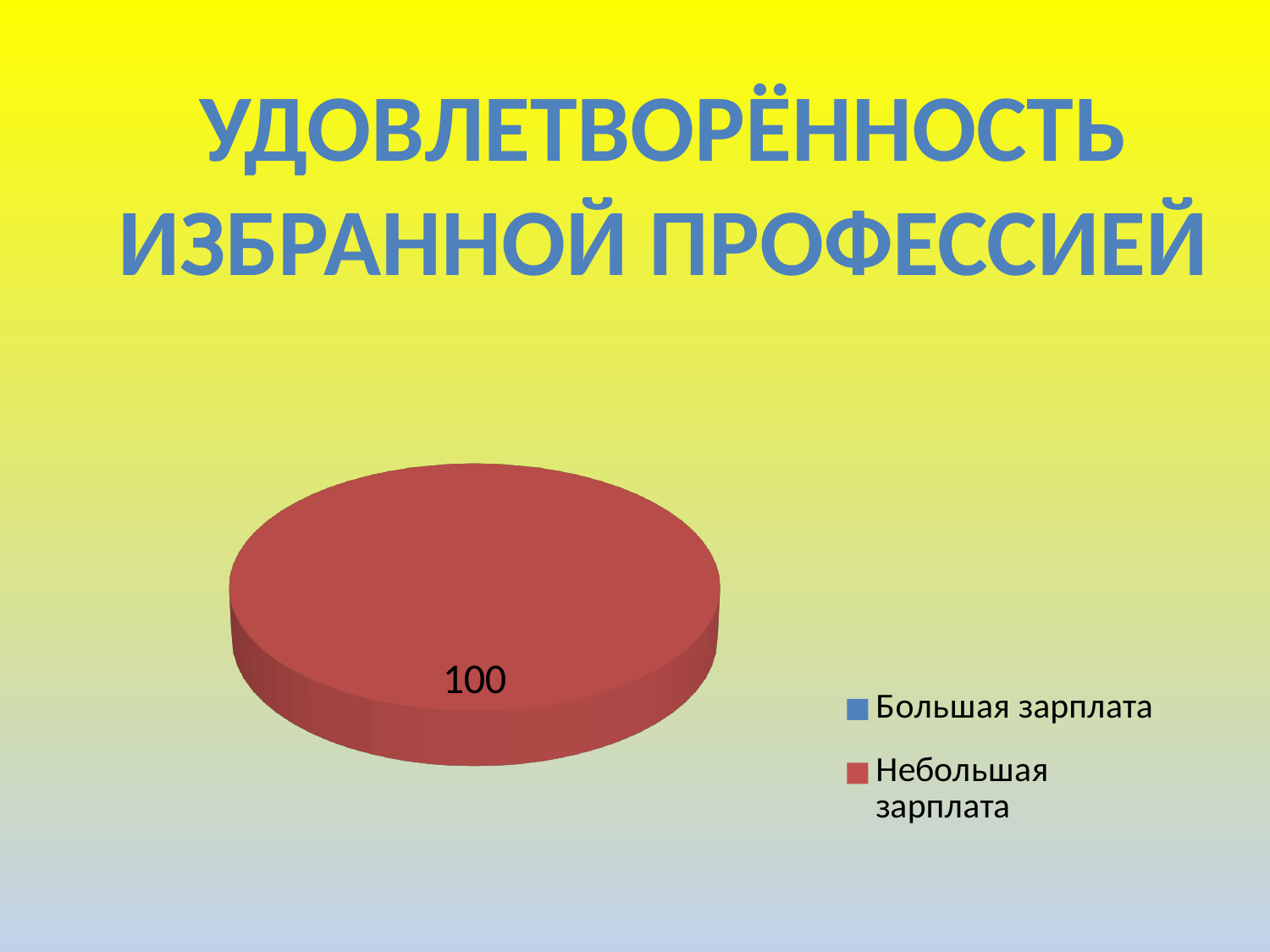
What share of the pie does the Небольшая зарплата slice take up? 100% What value is printed on the pie slice for Небольшая зарплата? 100 Which is larger, the slice for Большая зарплата or the slice for Небольшая зарплата? Небольшая зарплата What colour is the Небольшая зарплата slice? red How many slices are visible in the pie? 1 Which category has the smallest share of the pie? Большая зарплата How many categories does the legend list? 2 Which category makes up the largest part of the pie? Небольшая зарплата What is the title of the slide above the chart? УДОВЛЕТВОРЁННОСТЬ ИЗБРАННОЙ ПРОФЕССИЕЙ What kind of chart is shown on the slide? pie chart